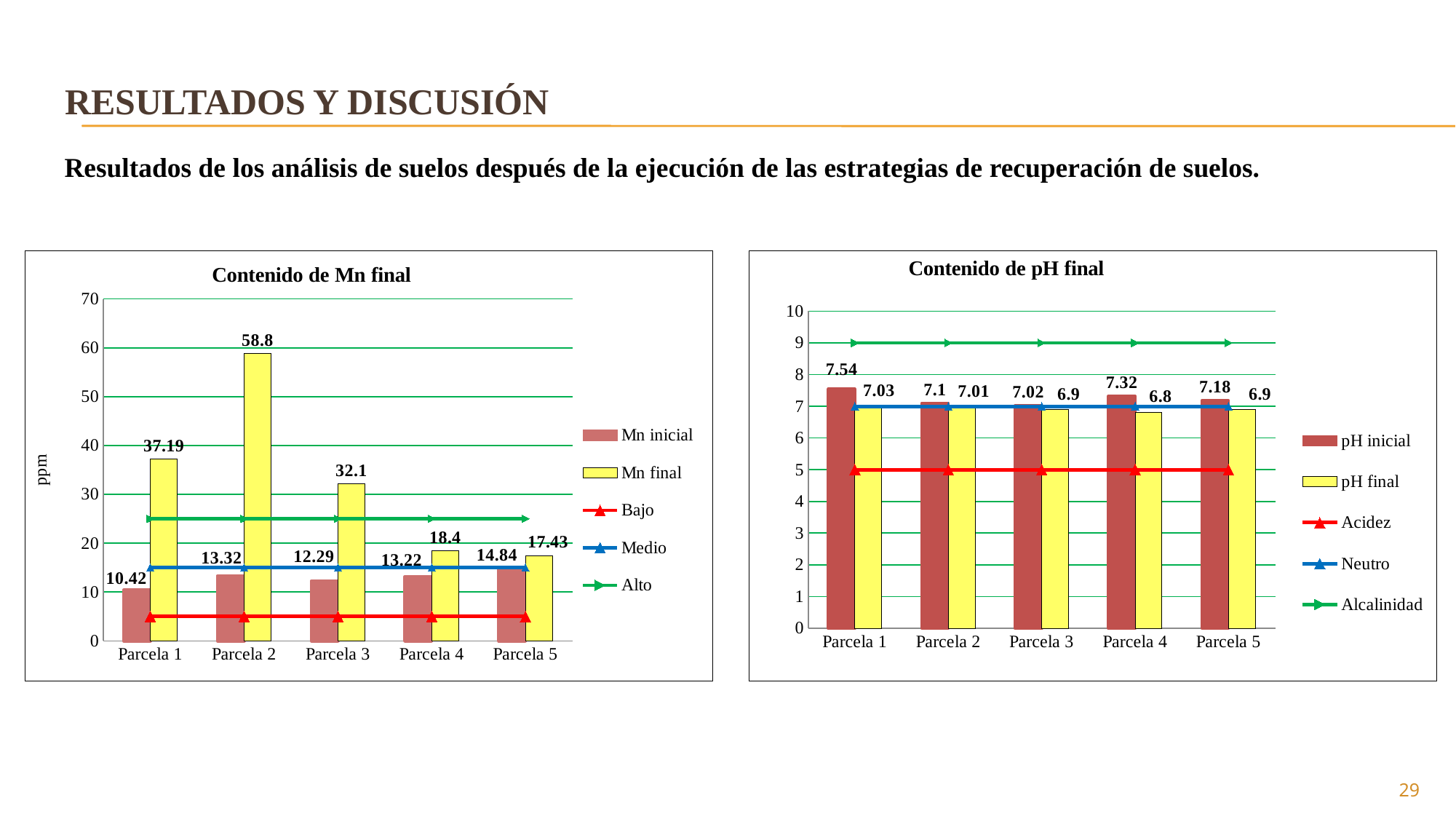
In the 'Contenido de Mn final' chart, which parcela has the highest Mn final value? Parcela 2 In the 'Contenido de Mn final' chart, what is the difference between Mn final and Mn inicial for Parcela 3? 19.81 In the 'Contenido de Mn final' chart, which parcela has the lowest Mn inicial value? Parcela 1 How many series does the legend of the 'Contenido de Mn final' chart list? 5 In the 'Contenido de Mn final' chart, what is the Mn inicial value for Parcela 1? 10.42 In the 'Contenido de pH final' chart, what is the pH inicial value for Parcela 4? 7.32 In the 'Contenido de pH final' chart, which parcela has the highest pH inicial value? Parcela 1 In the 'Contenido de pH final' chart, at what value is the Alcalinidad line drawn? 9 In the 'Contenido de pH final' chart, what is the pH final value for Parcela 4? 6.8 How many parcelas are shown on the x axis of the 'Contenido de pH final' chart? 5 In the 'Contenido de Mn final' chart, what is the Mn final value for Parcela 2? 58.8 In the 'Contenido de Mn final' chart, is the Mn final value for Parcela 2 greater or less than 50? greater